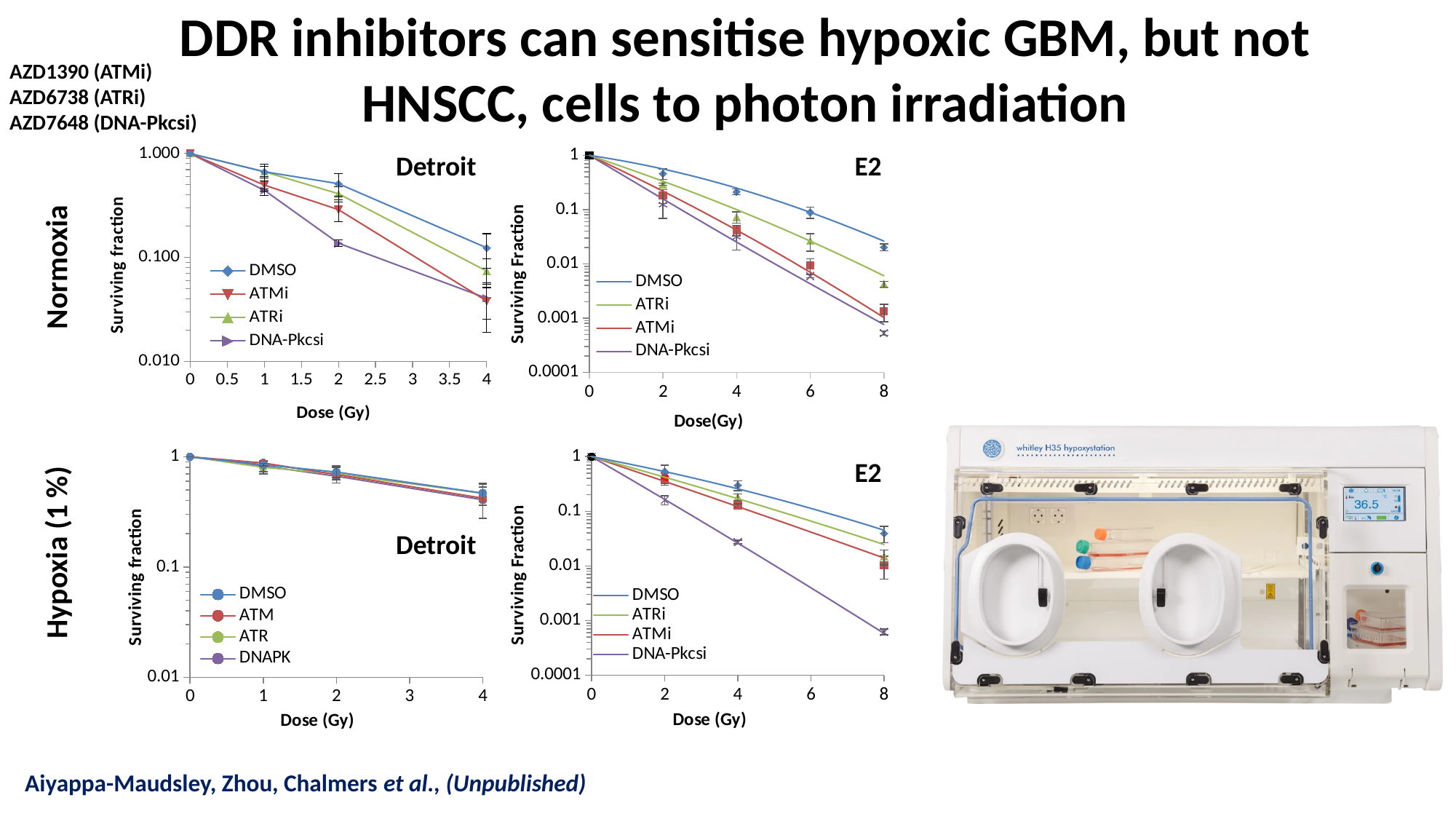
In the Hypoxia E2 chart (bottom right), which series has the highest surviving fraction at 8 Gy? DMSO In the Hypoxia E2 chart (bottom right), is the surviving fraction for DNA-Pkcsi at 8 Gy greater or less than 0.001? less In the Normoxia E2 chart (top right), does the surviving fraction rise or fall as dose increases? fall In the Normoxia Detroit chart (top left), is the surviving fraction for ATMi at 4 Gy greater or less than 0.100? less In the Normoxia E2 chart (top right), which series has the lowest surviving fraction at 8 Gy? DNA-Pkcsi What are the four legend entries in the Hypoxia Detroit chart (bottom left)? DMSO, ATM, ATR, DNAPK What kind of chart is the Normoxia Detroit chart (top left)? line chart In the Hypoxia Detroit chart (bottom left), is the surviving fraction for DMSO at 4 Gy greater or less than 0.1? greater In the Normoxia E2 chart (top right), at 4 Gy, which is larger: the surviving fraction for DMSO or for DNA-Pkcsi? DMSO How many series does the legend of the Normoxia E2 chart (top right) list? 4 How many dose points are plotted per series in the Normoxia E2 chart (top right)? 5